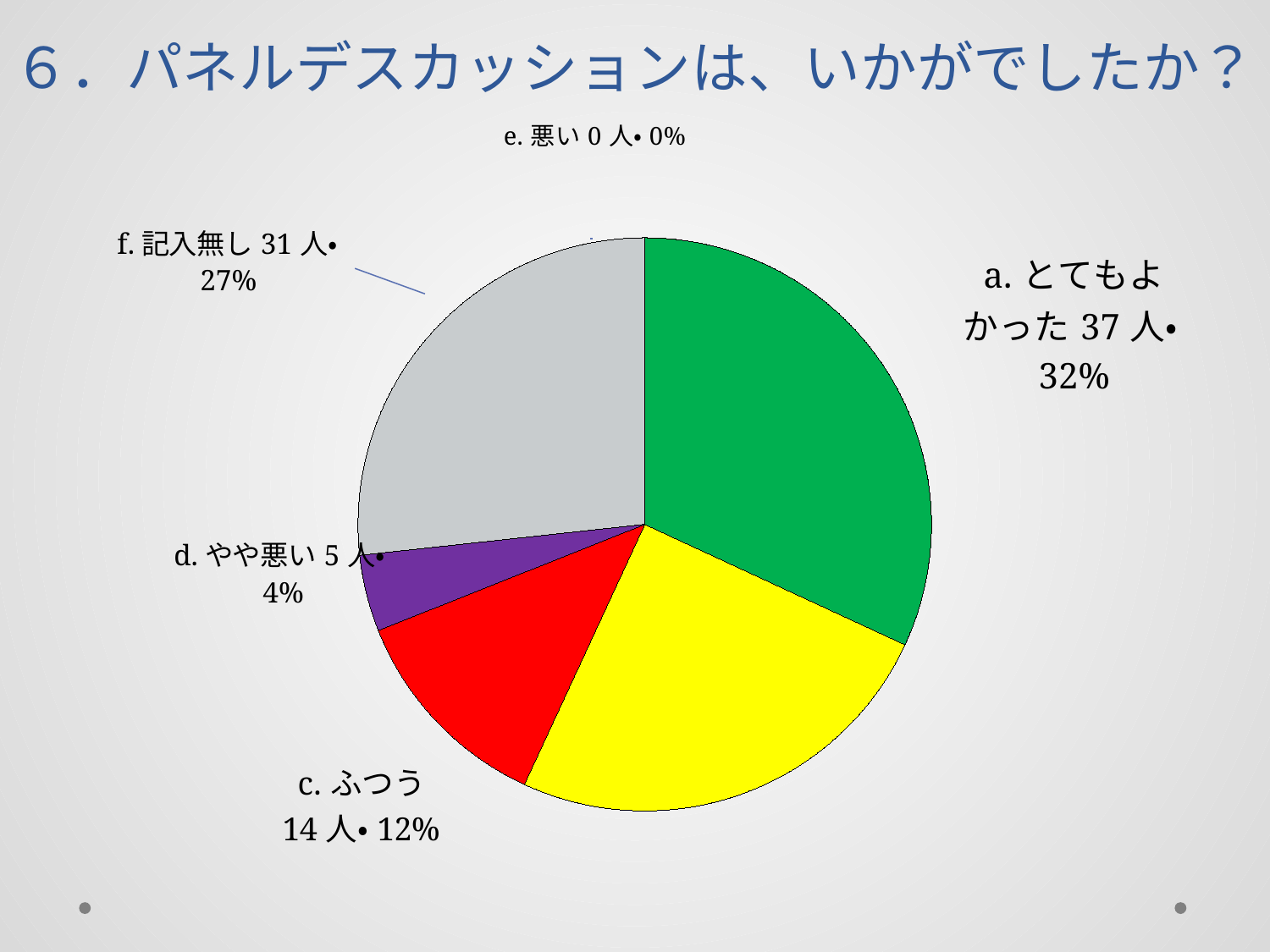
What colour is the slice for "a. とてもよかった"? green What percentage of responses is "d. やや悪い"? 4% How many people answered "e. 悪い"? 0 人 What kind of chart is shown on the slide? pie chart What is the difference in percentage points between "f. 記入無し" and "c. ふつう"? 15% What percentage of responses is "f. 記入無し"? 27% Which labeled category has the smallest share of the pie? e. 悪い Which has more respondents, "c. ふつう" or "d. やや悪い"? c. ふつう How many people answered "a. とてもよかった"? 37 人 Which labeled category has the largest share of the pie? a. とてもよかった How many more people answered "a. とてもよかった" than "f. 記入無し"? 6 人 How many people answered "c. ふつう"? 14 人